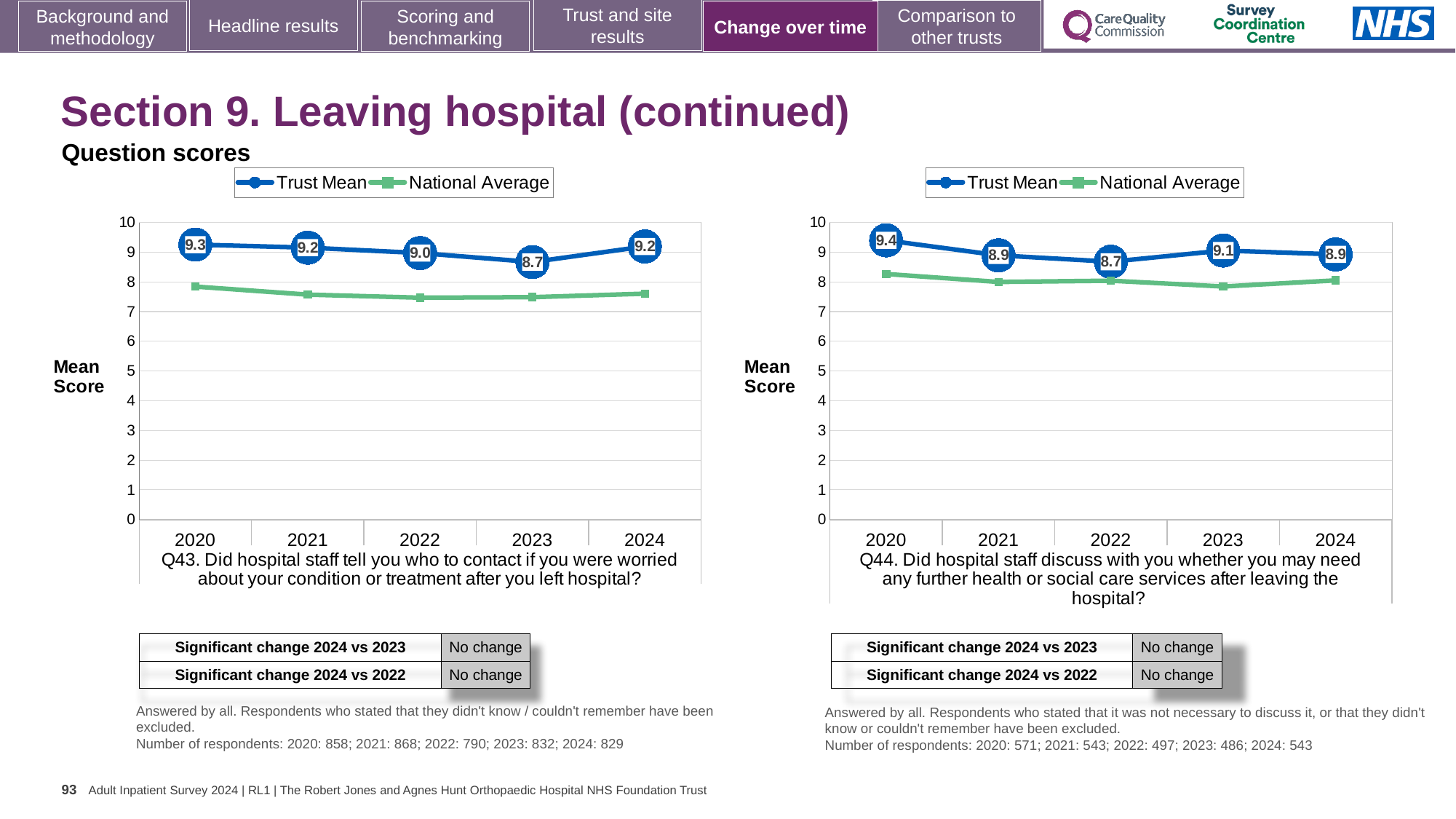
In the left chart (Q43), is the National Average for 2022 greater or less than 8? less In the left chart (Q43), what is the Trust Mean score for 2023? 8.7 In the right chart (Q44), what is the Trust Mean score for 2023? 9.1 In the left chart (Q43), what is the difference between the Trust Mean scores for 2020 and 2023? 0.6 In the left chart (Q43), which year has the lowest Trust Mean score? 2023 In the right chart (Q44), is the National Average for 2020 greater or less than 8? greater How many series does the legend of the left chart (Q43) list? 2 In the right chart (Q44), is the Trust Mean for 2022 larger or smaller than the Trust Mean for 2023? smaller What type of chart is the right chart (Q44)? Line chart In the right chart (Q44), what is the Trust Mean score for 2020? 9.4 In the right chart (Q44), which year has the highest Trust Mean score? 2020 In the left chart (Q43), what is the Trust Mean score for 2020? 9.3